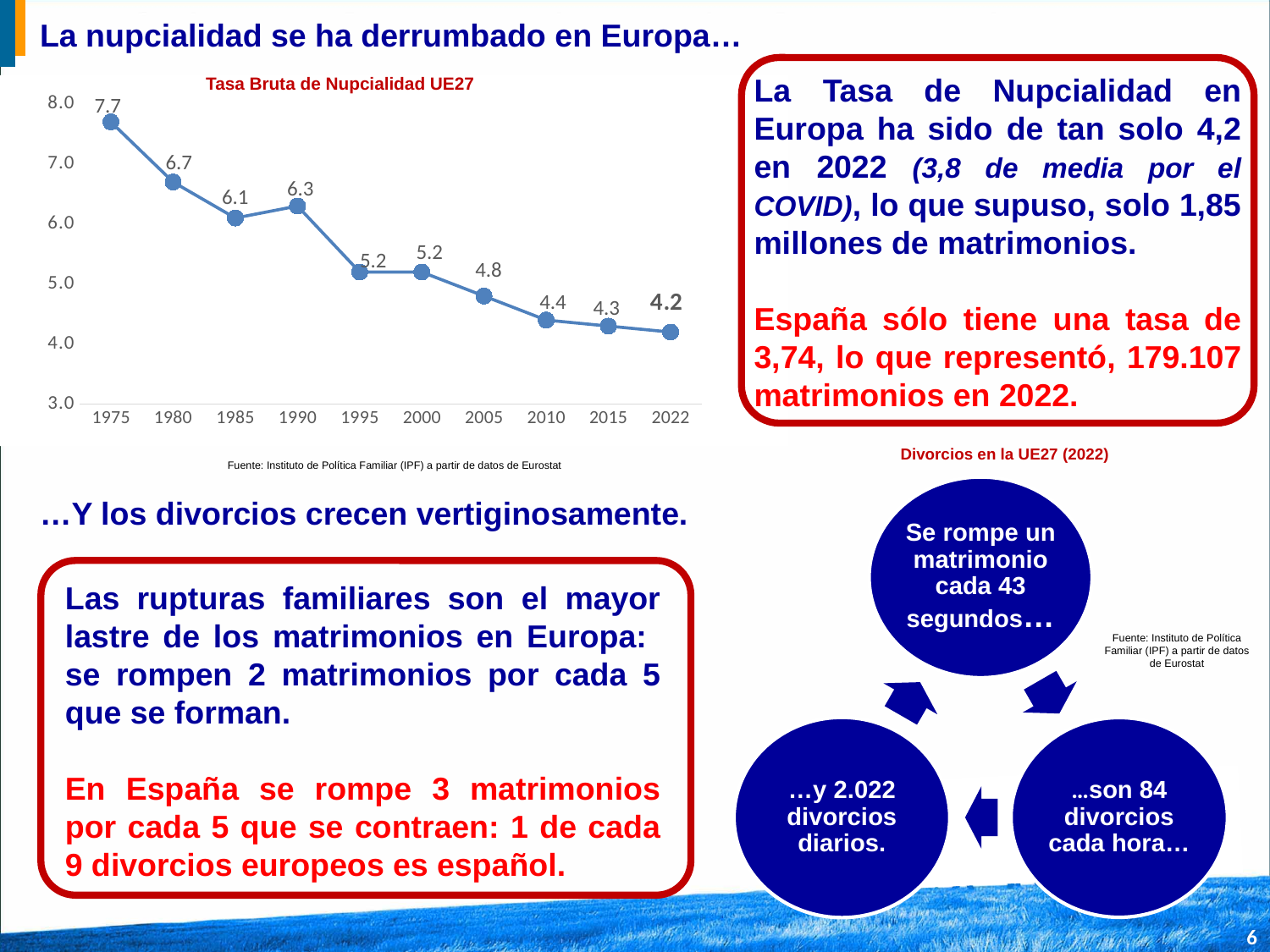
What is the value for 2022 in the Tasa Bruta de Nupcialidad UE27 chart? 4.2 Is the value for 2005 in the Tasa Bruta de Nupcialidad UE27 chart greater or less than 5.0? less What kind of chart is the Tasa Bruta de Nupcialidad UE27 chart? line chart What is the difference between the values for 1975 and 2022 in the Tasa Bruta de Nupcialidad UE27 chart? 3.5 What is the value for 1975 in the Tasa Bruta de Nupcialidad UE27 chart? 7.7 Which year has the highest value in the Tasa Bruta de Nupcialidad UE27 chart? 1975 In the Tasa Bruta de Nupcialidad UE27 chart, which is larger, the value for 1985 or the value for 1990? 1990 What is the title of the line chart on the slide? Tasa Bruta de Nupcialidad UE27 Which year has the lowest value in the Tasa Bruta de Nupcialidad UE27 chart? 2022 What is the value for 1990 in the Tasa Bruta de Nupcialidad UE27 chart? 6.3 Do the values in the Tasa Bruta de Nupcialidad UE27 chart generally rise or fall from 1975 to 2022? fall How many data points are plotted in the Tasa Bruta de Nupcialidad UE27 chart? 10